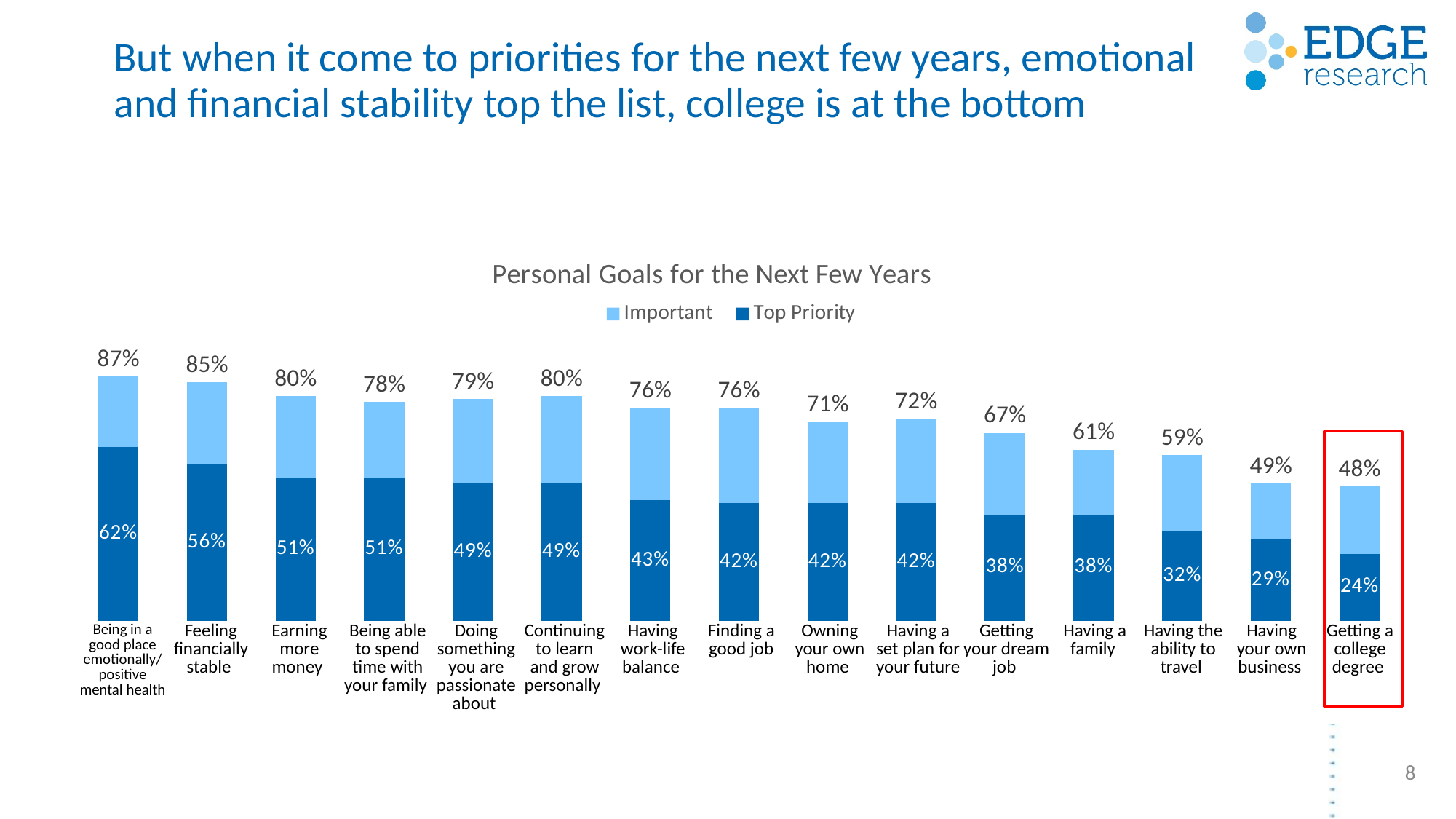
What is the Top Priority value for 'Getting a college degree'? 24% What is the Top Priority value for 'Feeling financially stable'? 56% What is the total value shown above the bar for 'Having work-life balance'? 76% Which has a larger Top Priority value, 'Having a family' or 'Having your own business'? Having a family Do the total values generally rise or fall moving from left to right along the x axis? fall What type of chart is shown on the slide? bar chart Which category has the lowest total value? Getting a college degree Which category has the highest Top Priority value? Being in a good place emotionally/positive mental health What is the title of the chart? Personal Goals for the Next Few Years What is the difference between the Top Priority values for 'Earning more money' and 'Having the ability to travel'? 19% How many series does the legend list? 2 How many categories are shown on the x axis of the chart? 15